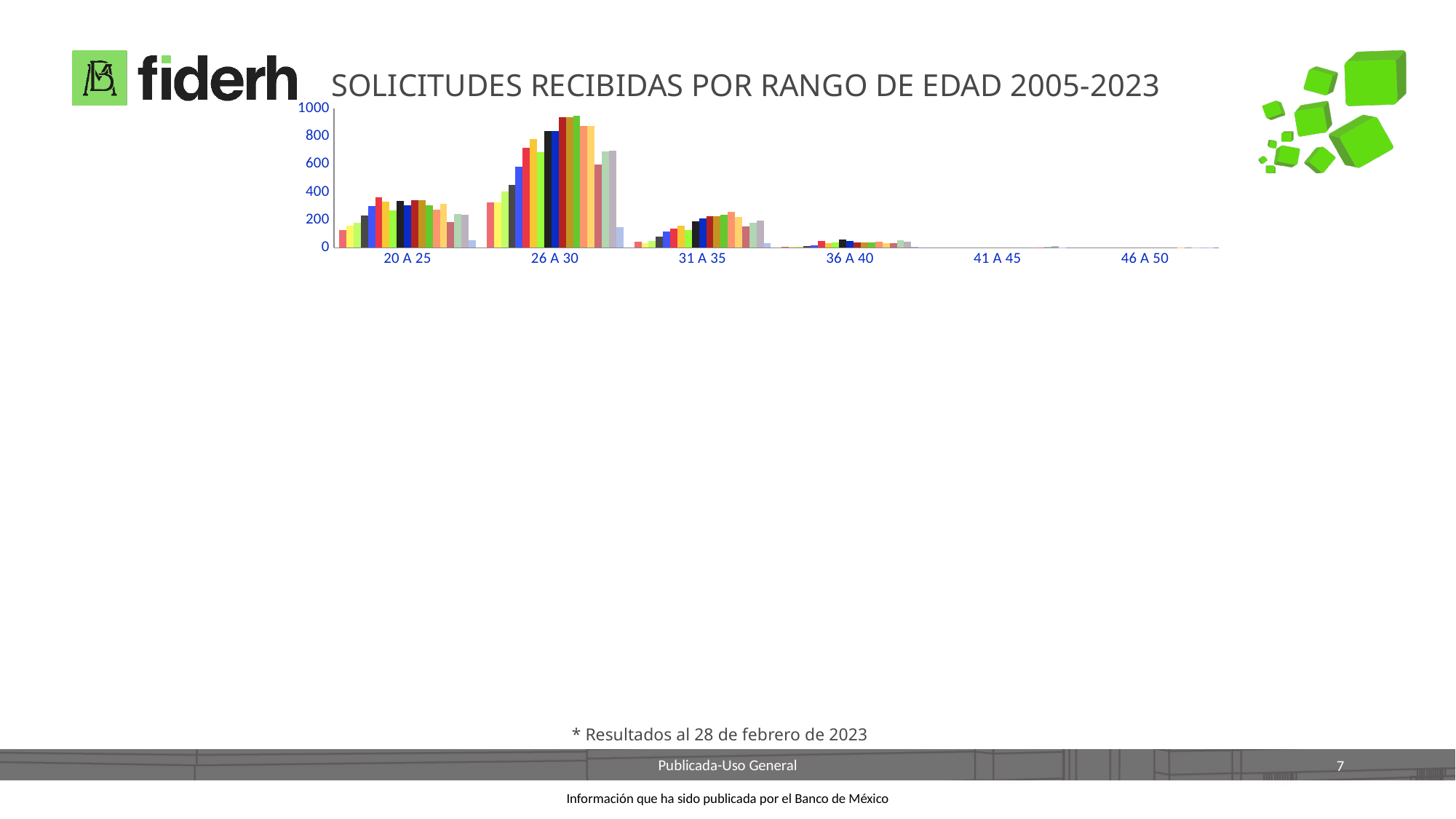
Is the tallest bar in the 26 A 30 group greater or less than 800? greater What is the title of the chart? SOLICITUDES RECIBIDAS POR RANGO DE EDAD 2005-2023 Is the tallest bar in the 20 A 25 group greater or less than 200? greater What kind of chart is shown on the slide? Bar chart Which group has taller bars overall, 26 A 30 or 31 A 35? 26 A 30 How many age-range categories are shown on the x axis? 6 Are the bars in the 41 A 45 group greater or less than 200? less Which age range has the tallest bars in the chart? 26 A 30 Which group has taller bars overall, 20 A 25 or 36 A 40? 20 A 25 What is the maximum value shown on the vertical axis? 1000